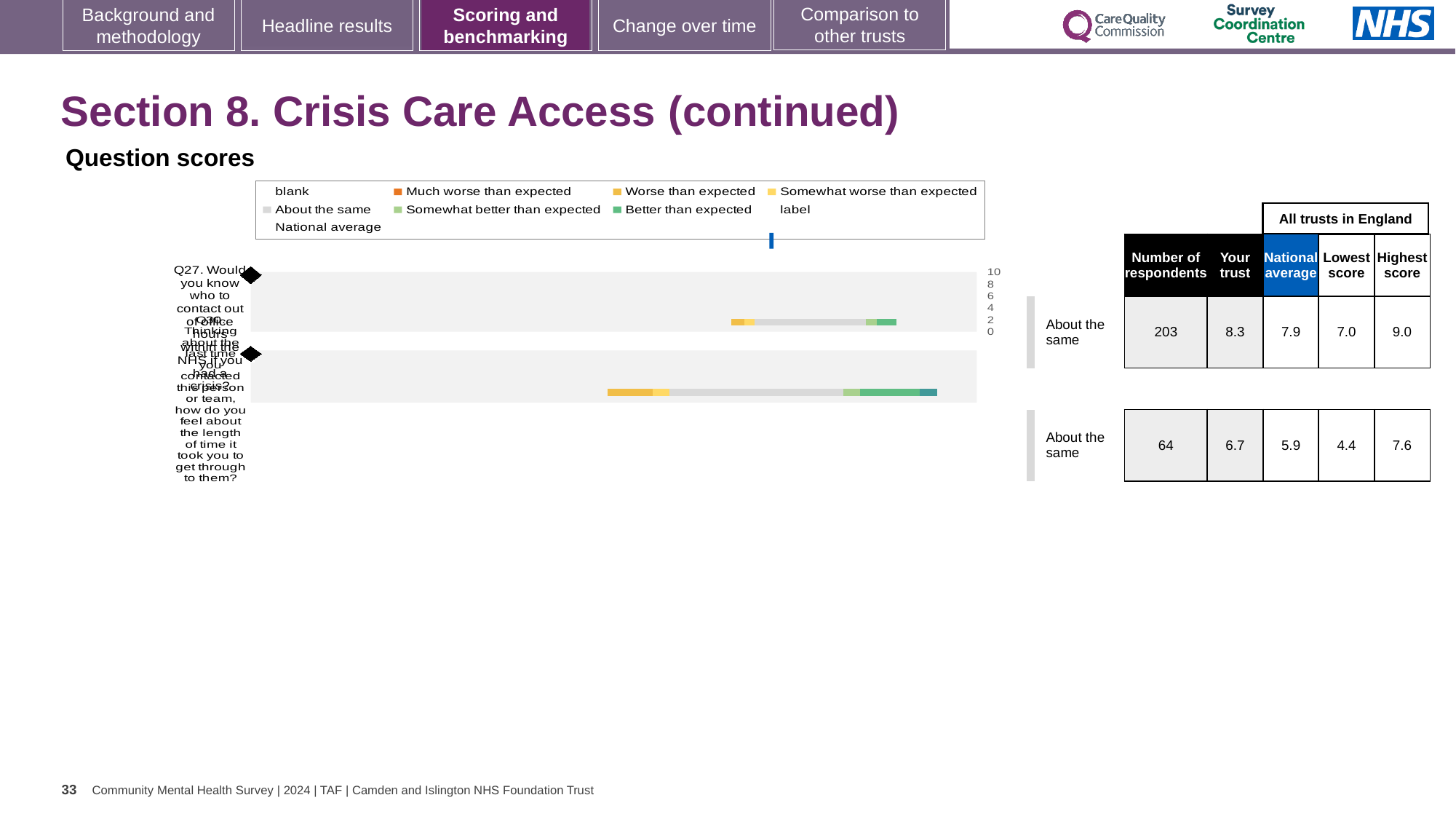
How many survey questions are plotted as bars in the chart? 2 What is the difference between the 'Your trust' scores for Q27 (8.3) and Q30 (6.7)? 1.6 What benchmark category is shown next to the Q30 bar? About the same Which question has the higher 'Your trust' score, Q27 or Q30? Q27 In the table beside the chart, what is the national average score for Q30? 5.9 What is the highest tick value shown on the chart's score axis? 10 What colour does the legend use for 'Much worse than expected'? orange In the table beside the chart, what is the 'Your trust' score for Q27? 8.3 Which question has the larger number of respondents, Q27 or Q30? Q27 In the table beside the chart, how many respondents answered Q30? 64 In the table beside the chart, what is the highest score across all trusts in England for Q27? 9.0 What kind of chart is shown under 'Question scores'? bar chart